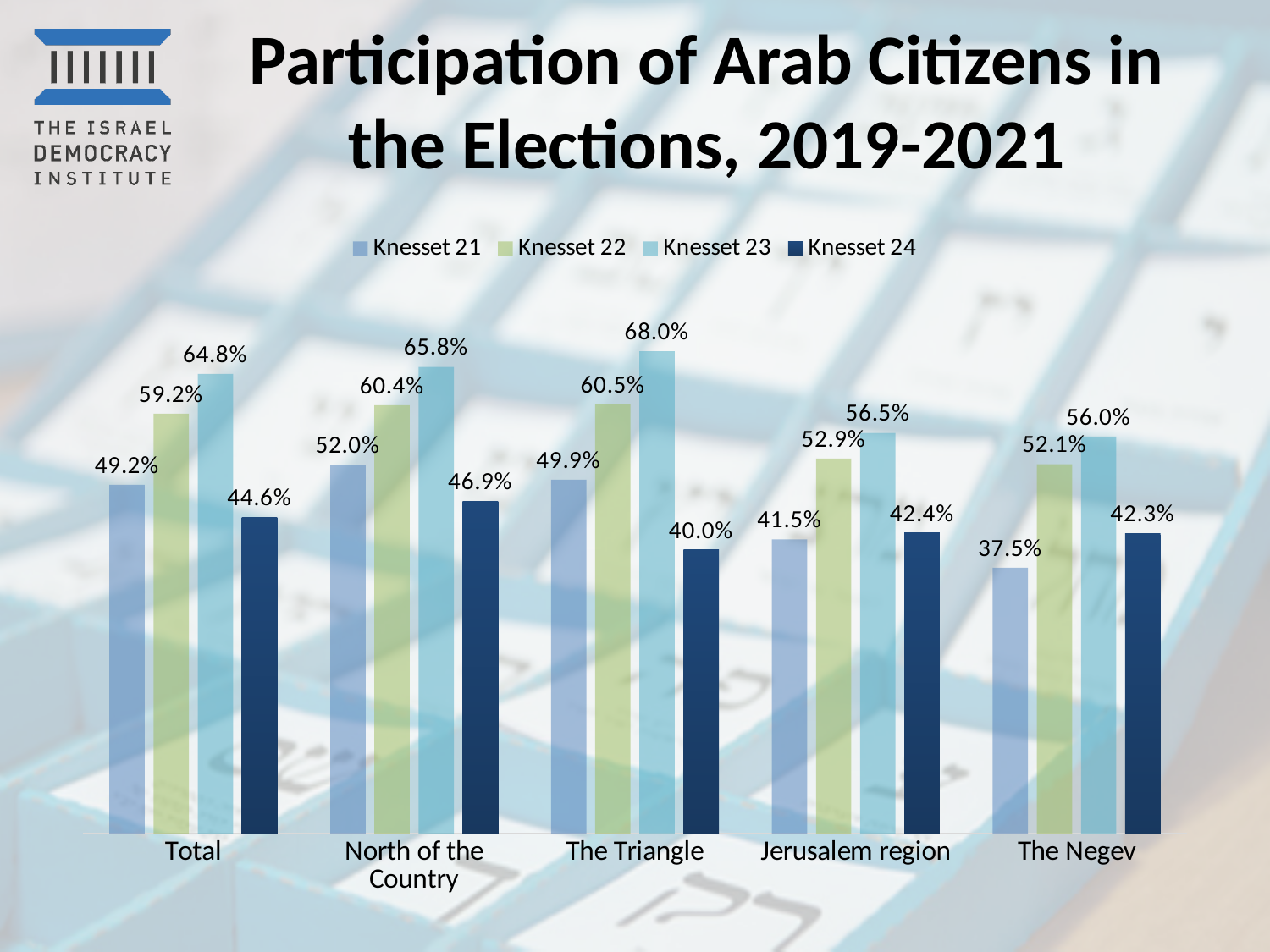
Which region had the highest participation rate for Knesset 23? The Triangle Which is larger: the Knesset 22 rate in the Jerusalem region or the Knesset 22 rate in The Negev? Jerusalem region In the North of the Country, did participation rise or fall from Knesset 23 to Knesset 24? Fall How many regions (categories) are shown on the x axis? 5 Which region had the lowest participation rate for Knesset 24? The Triangle How many series does the legend list? 4 What was the Total participation rate for Knesset 24? 44.6% What kind of chart is shown on the slide? Bar chart What was the participation rate for Knesset 21 in The Negev? 37.5% What is the difference between the Knesset 23 and Knesset 24 participation rates in The Triangle? 28.0% What was the participation rate for Knesset 23 in The Triangle? 68.0% What is the title of the chart? Participation of Arab Citizens in the Elections, 2019-2021